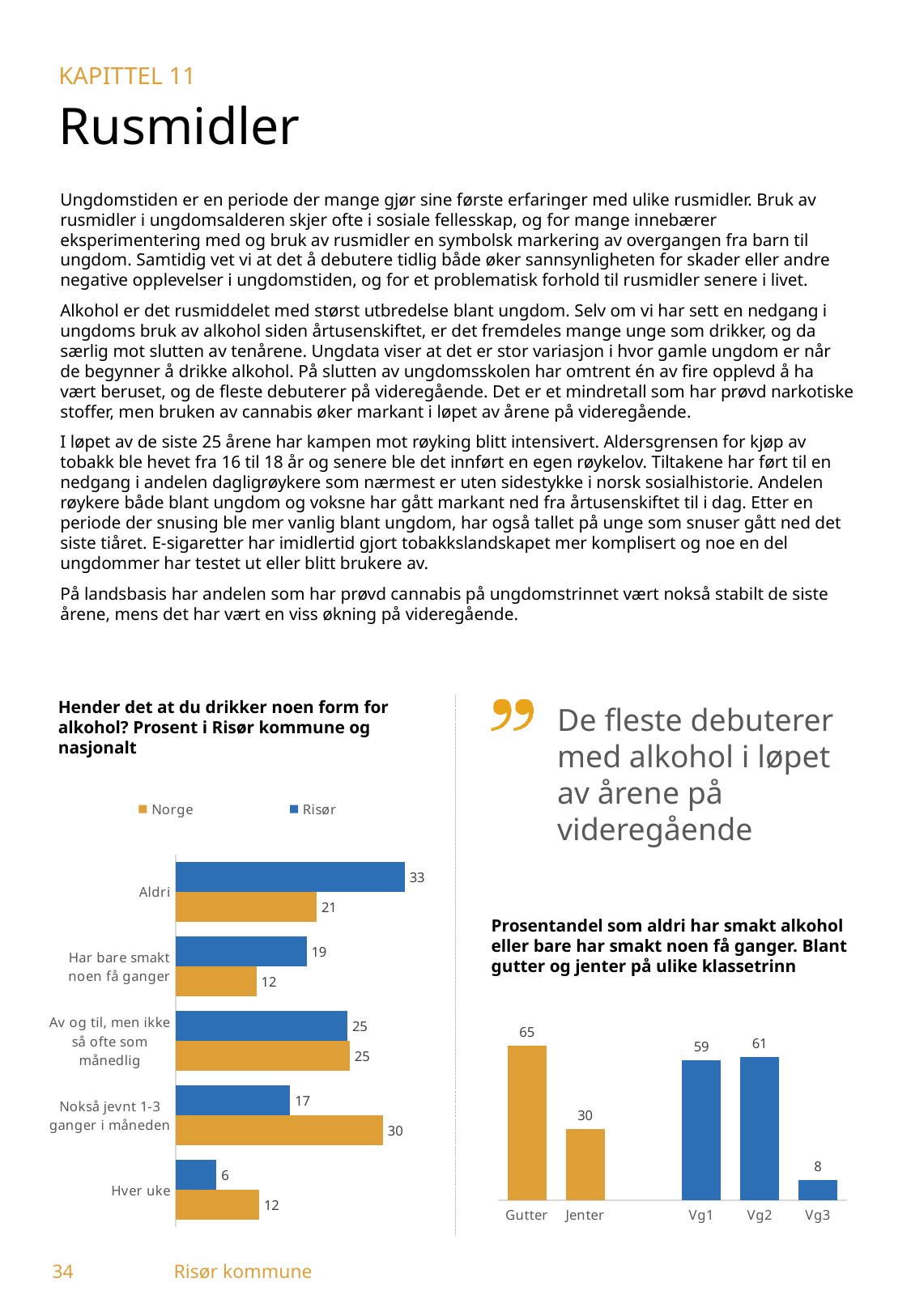
In the chart 'Hender det at du drikker noen form for alkohol?', what is the value for Norge in the category 'Nokså jevnt 1-3 ganger i måneden'? 30 In the chart 'Prosentandel som aldri har smakt alkohol eller bare har smakt noen få ganger', which category has the lowest value? Vg3 In the chart 'Hender det at du drikker noen form for alkohol?', which colour represents Norge? Orange In the chart 'Prosentandel som aldri har smakt alkohol eller bare har smakt noen få ganger', which category has the highest value? Gutter In the chart 'Hender det at du drikker noen form for alkohol?', how many categories are shown? 5 In the chart 'Prosentandel som aldri har smakt alkohol eller bare har smakt noen få ganger', what is the difference between Vg2 and Vg3? 53 What kind of chart is 'Hender det at du drikker noen form for alkohol?'? Bar chart In the chart 'Hender det at du drikker noen form for alkohol?', what is the difference between Risør and Norge in the category 'Aldri'? 12 In the chart 'Prosentandel som aldri har smakt alkohol eller bare har smakt noen få ganger', what is the value for Jenter? 30 In the chart 'Hender det at du drikker noen form for alkohol?', which is larger for 'Hver uke': Norge or Risør? Norge In the chart 'Hender det at du drikker noen form for alkohol?', how many series does the legend list? 2 In the chart 'Hender det at du drikker noen form for alkohol?', what is the value for Risør in the category 'Aldri'? 33